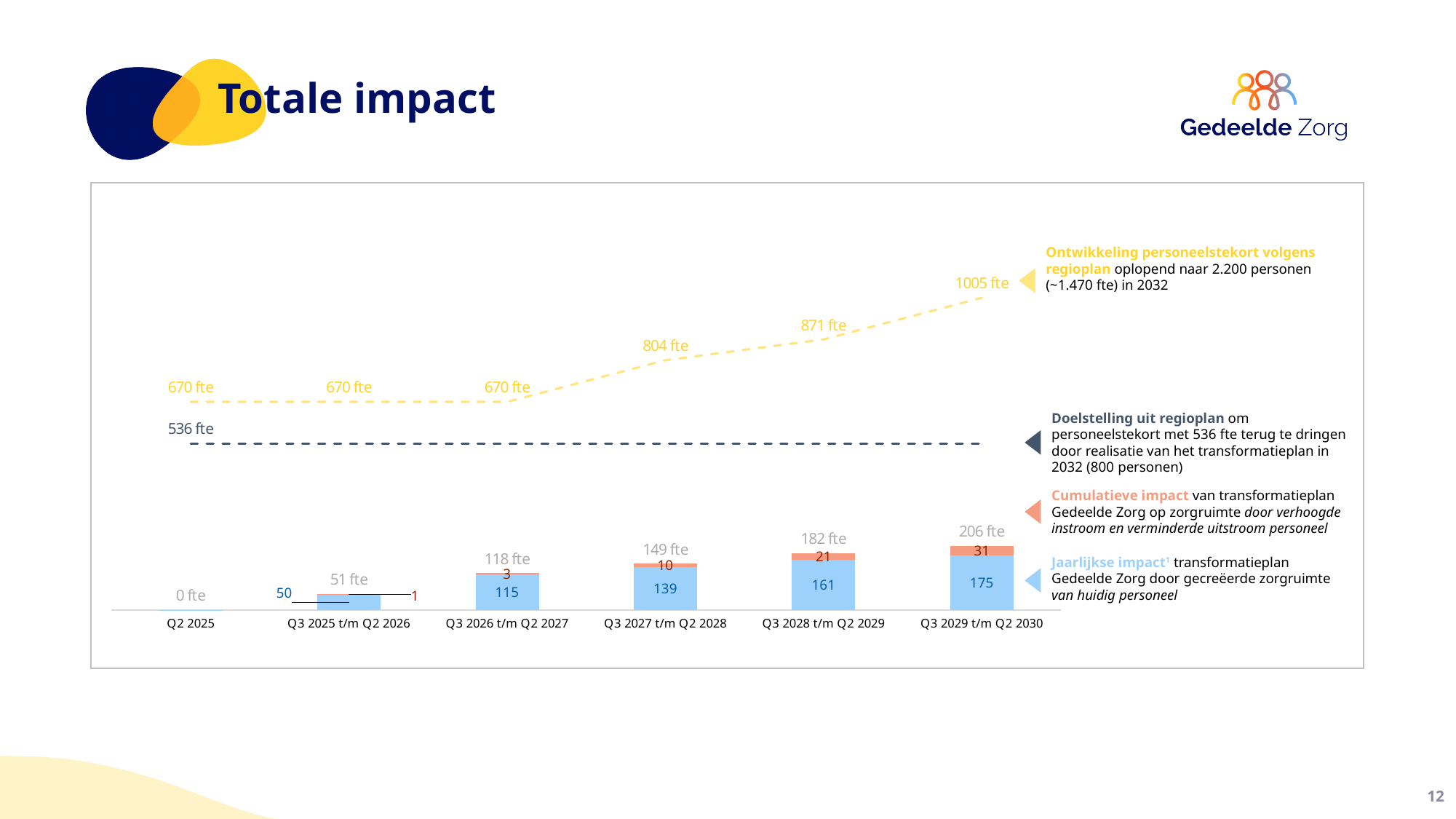
What is the Jaarlijkse impact (blue segment) value for Q3 2027 t/m Q2 2028? 139 Is the Jaarlijkse impact value for Q3 2026 t/m Q2 2027 larger or smaller than the value for Q3 2027 t/m Q2 2028? smaller Which period has the highest total impact bar? Q3 2029 t/m Q2 2030 What is the total of the stacked bar for Q3 2026 t/m Q2 2027 (115 + 3)? 118 fte What value does the yellow dashed line (Ontwikkeling personeelstekort volgens regioplan) show for Q3 2029 t/m Q2 2030? 1005 fte What is the total impact (in fte) shown above the bar for Q3 2029 t/m Q2 2030? 206 fte How many periods are shown on the x axis of the chart? 6 What is the Cumulatieve impact (orange segment) value for Q3 2028 t/m Q2 2029? 21 What value does the dark dashed line labelled Doelstelling uit regioplan show? 536 fte Which period has the lowest total impact bar? Q2 2025 What is the difference between the total impact for Q3 2029 t/m Q2 2030 (206 fte) and Q3 2028 t/m Q2 2029 (182 fte)? 24 fte Do the total impact values rise or fall from Q2 2025 to Q3 2029 t/m Q2 2030? rise